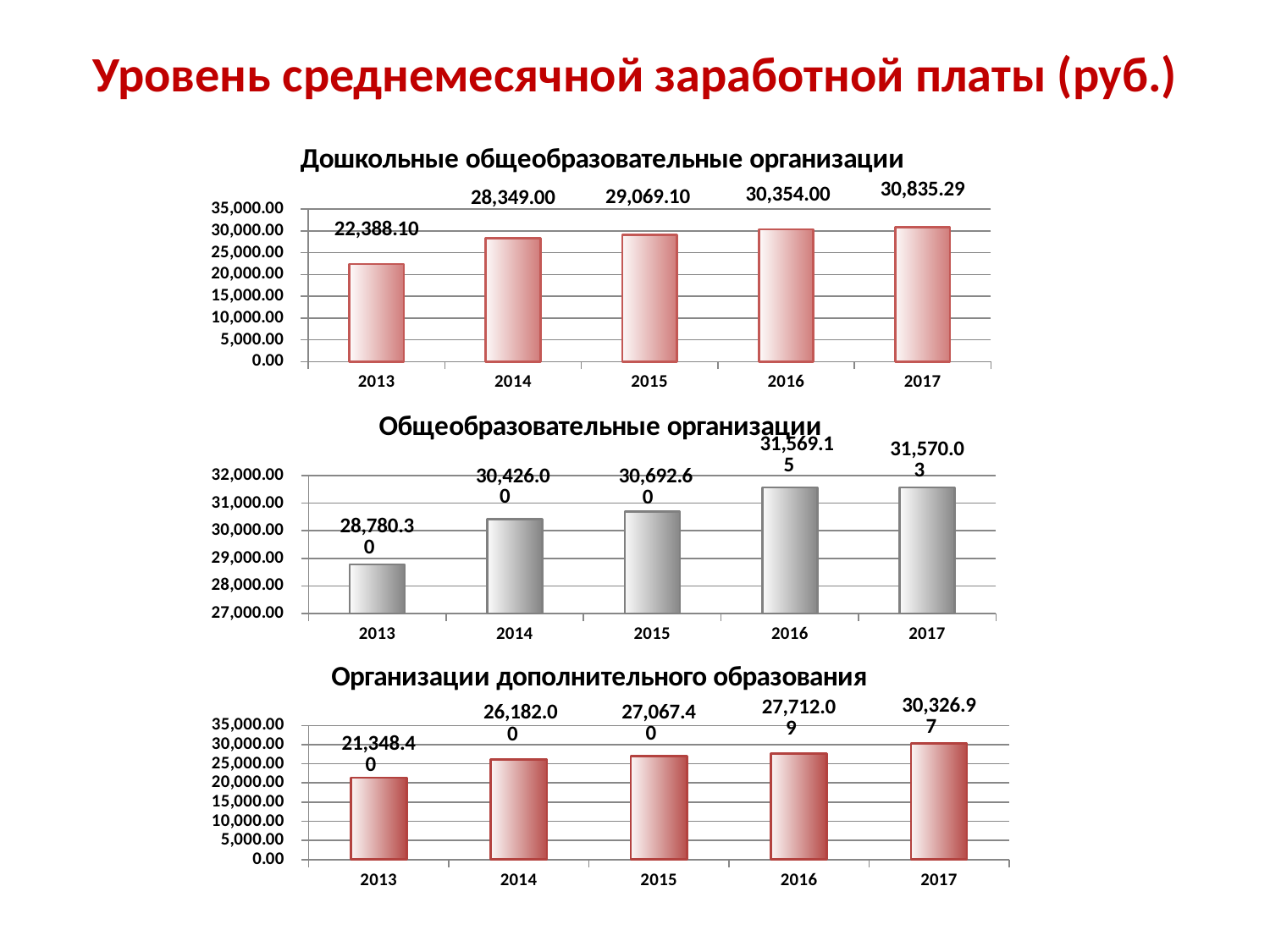
In the chart titled 'Организации дополнительного образования', which is larger, the value for 2014 or the value for 2015? 2015 How many years are shown on the x axis of the chart titled 'Общеобразовательные организации'? 5 In the chart titled 'Организации дополнительного образования', what is the value for 2016? 27,712.09 In the chart titled 'Организации дополнительного образования', which year has the highest value? 2017 In the chart titled 'Дошкольные общеобразовательные организации', what is the value for 2013? 22,388.10 In the chart titled 'Организации дополнительного образования', do the values rise or fall from 2013 to 2017? rise In the chart titled 'Общеобразовательные организации', what is the value for 2013? 28,780.30 In the chart titled 'Общеобразовательные организации', what is the value for 2015? 30,692.60 In the chart titled 'Общеобразовательные организации', is the value for 2014 greater or less than 30,000.00? greater In the chart titled 'Дошкольные общеобразовательные организации', which year has the lowest value? 2013 In the chart titled 'Дошкольные общеобразовательные организации', what is the value for 2017? 30,835.29 In the chart titled 'Дошкольные общеобразовательные организации', what is the difference between the 2014 and 2013 values? 5,960.90